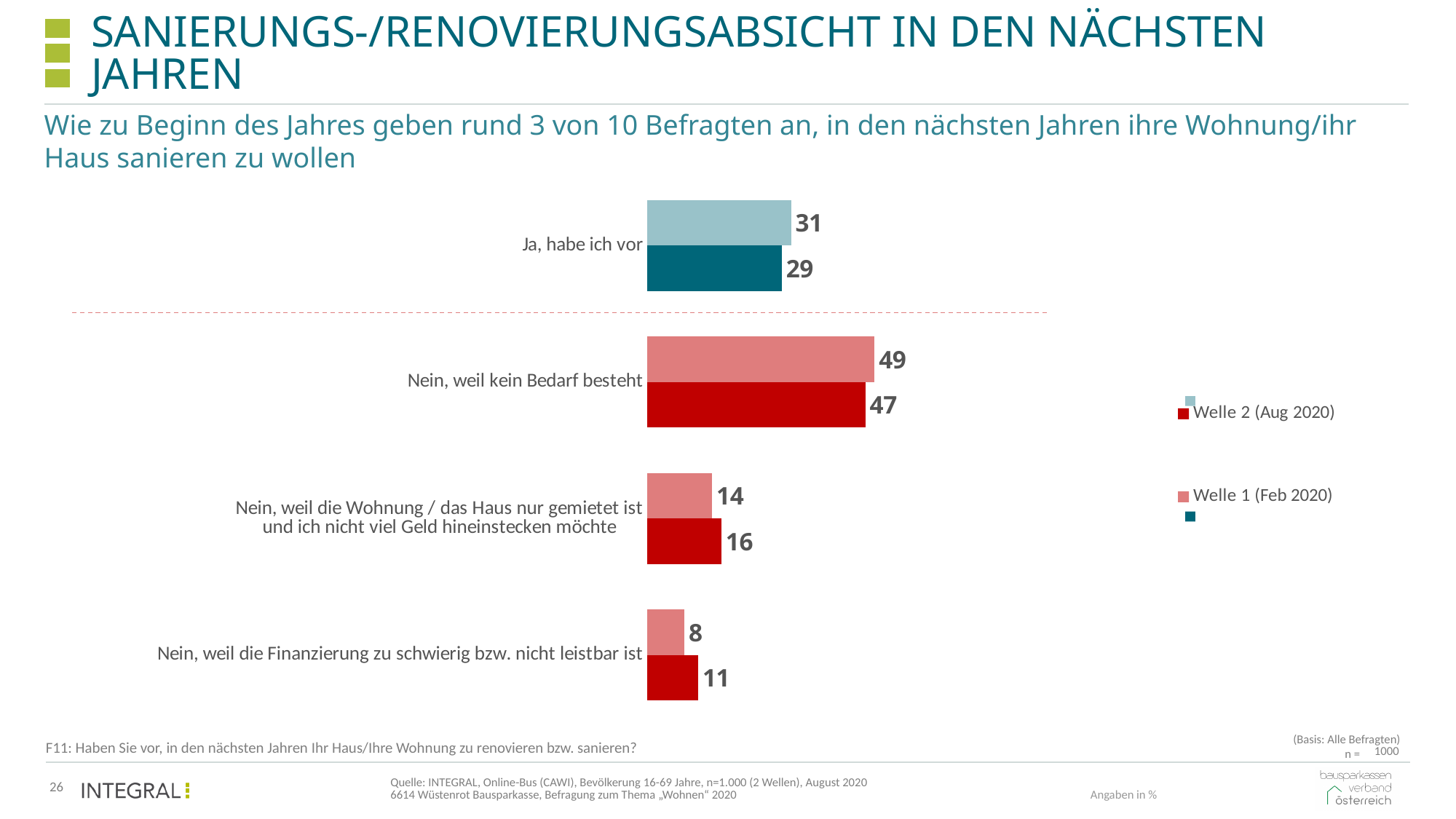
Which category has the highest value in Welle 1 (Feb 2020)? Nein, weil kein Bedarf besteht What is the value for "Nein, weil die Finanzierung zu schwierig bzw. nicht leistbar ist" in Welle 1 (Feb 2020)? 8 How many categories are shown in the chart? 4 What is the difference between the Welle 2 and Welle 1 values for "Nein, weil die Finanzierung zu schwierig bzw. nicht leistbar ist"? 3 How many waves (series) does the legend list? 2 What is the value for "Ja, habe ich vor" in Welle 2 (Aug 2020)? 29 What kind of chart is shown on the slide? bar chart For "Nein, weil die Wohnung / das Haus nur gemietet ist und ich nicht viel Geld hineinstecken möchte", which wave has the larger value, Welle 1 or Welle 2? Welle 2 What is the difference between the Welle 1 and Welle 2 values for "Nein, weil kein Bedarf besteht"? 2 Which category has the lowest value in Welle 2 (Aug 2020)? Nein, weil die Finanzierung zu schwierig bzw. nicht leistbar ist What is the value for "Nein, weil kein Bedarf besteht" in Welle 2 (Aug 2020)? 47 What is the value for "Ja, habe ich vor" in Welle 1 (Feb 2020)? 31